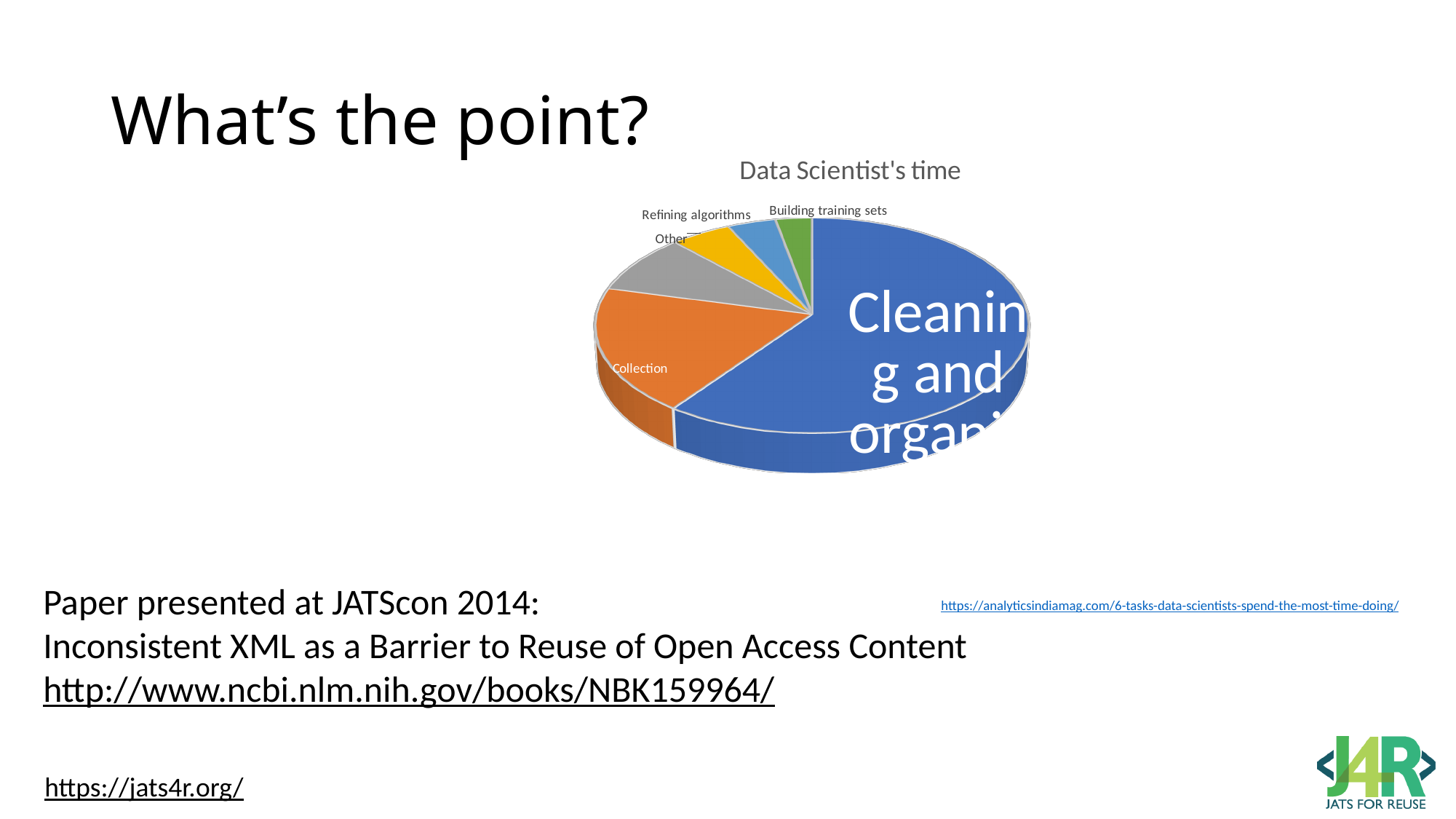
How many slices does the pie chart have? 6 Which category takes the largest share of the data scientist's time in the pie chart? Cleaning and organizing Which category is the second-largest slice of the pie chart? Collection What colour is the Collection slice in the pie chart? Orange What is the title of the chart? Data Scientist's time Which slice is larger, Collection or Other? Collection Which slice is larger, Other or Building training sets? Other What kind of chart is shown on the slide? Pie chart